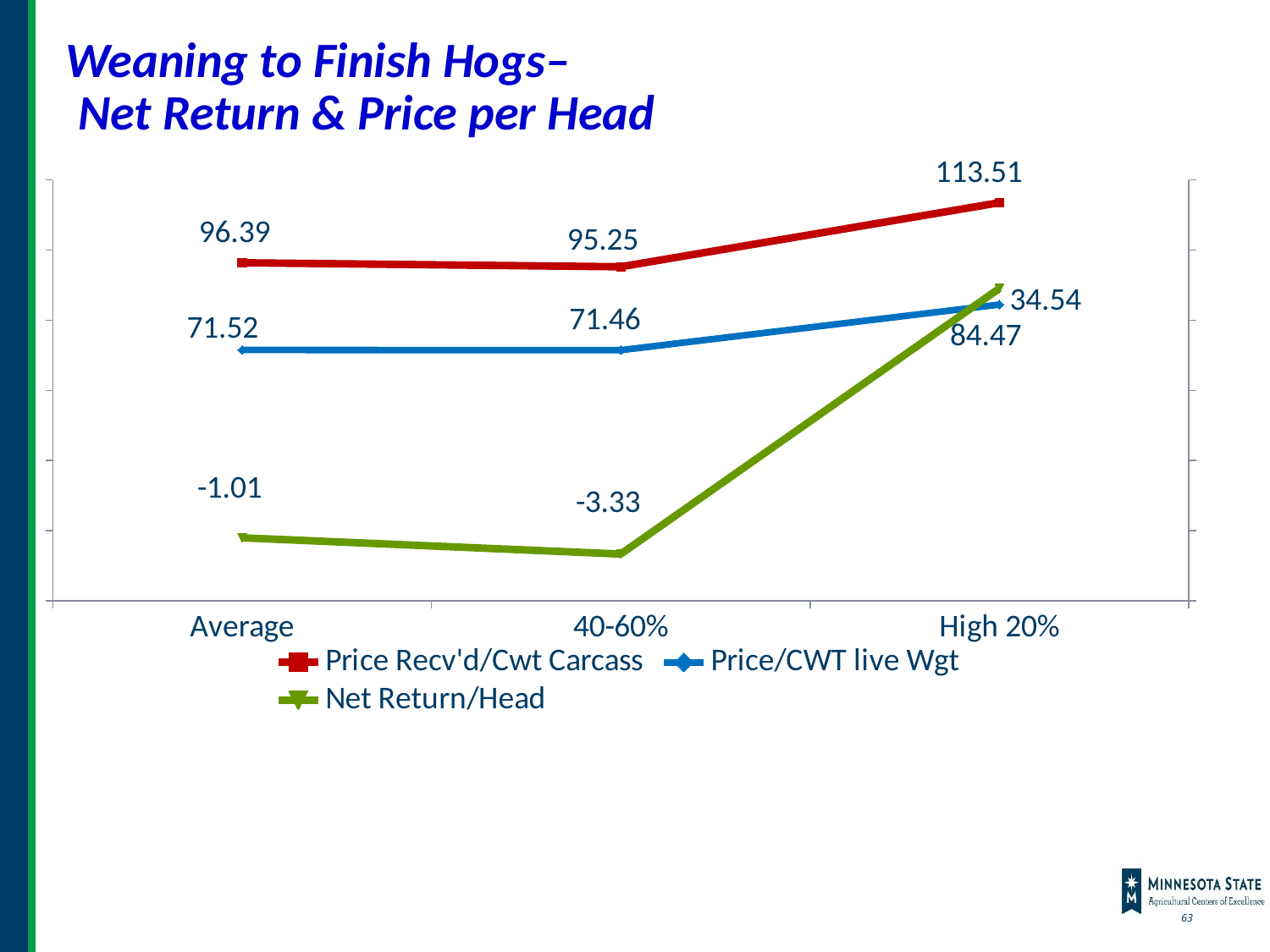
What is the Net Return/Head value for the 40-60% group? -3.33 How many series does the legend list? 3 What is the difference between the Price Recv'd/Cwt Carcass values for High 20% and 40-60%? 18.26 What is the Price Recv'd/Cwt Carcass value for the High 20% group? 113.51 Which group has the highest Price Recv'd/Cwt Carcass value? High 20% Which series is drawn in green? Net Return/Head What is the Price/CWT live Wgt value for the Average group? 71.52 What is the Net Return/Head value for the High 20% group? 34.54 How many groups are shown on the x axis? 3 What kind of chart is shown on the slide? Line chart Which group has the lowest Net Return/Head value? 40-60% Which is larger: the Price/CWT live Wgt value for High 20% or for Average? High 20%